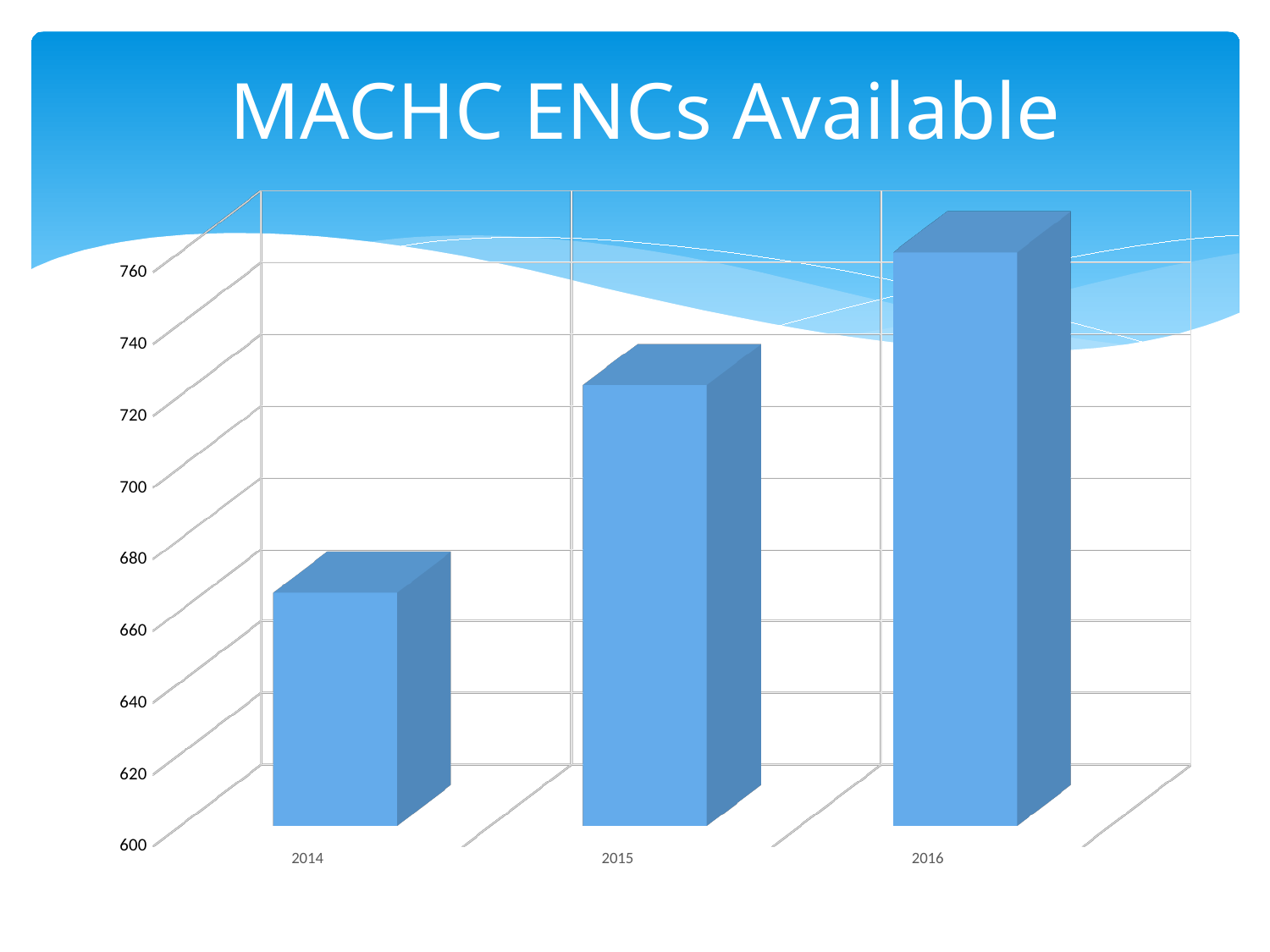
Which year has a larger value, 2014 or 2015? 2015 What kind of chart is shown on the slide? bar chart What is the title of the chart? MACHC ENCs Available Which year has the lowest number of MACHC ENCs available? 2014 How many years are shown on the x axis of the chart? 3 Do the values rise or fall from 2014 to 2016? rise Is the value for 2014 greater or less than 680? less Is the value for 2015 greater or less than 740? less Which year has the highest number of MACHC ENCs available? 2016 Is the value for 2016 greater or less than 740? greater